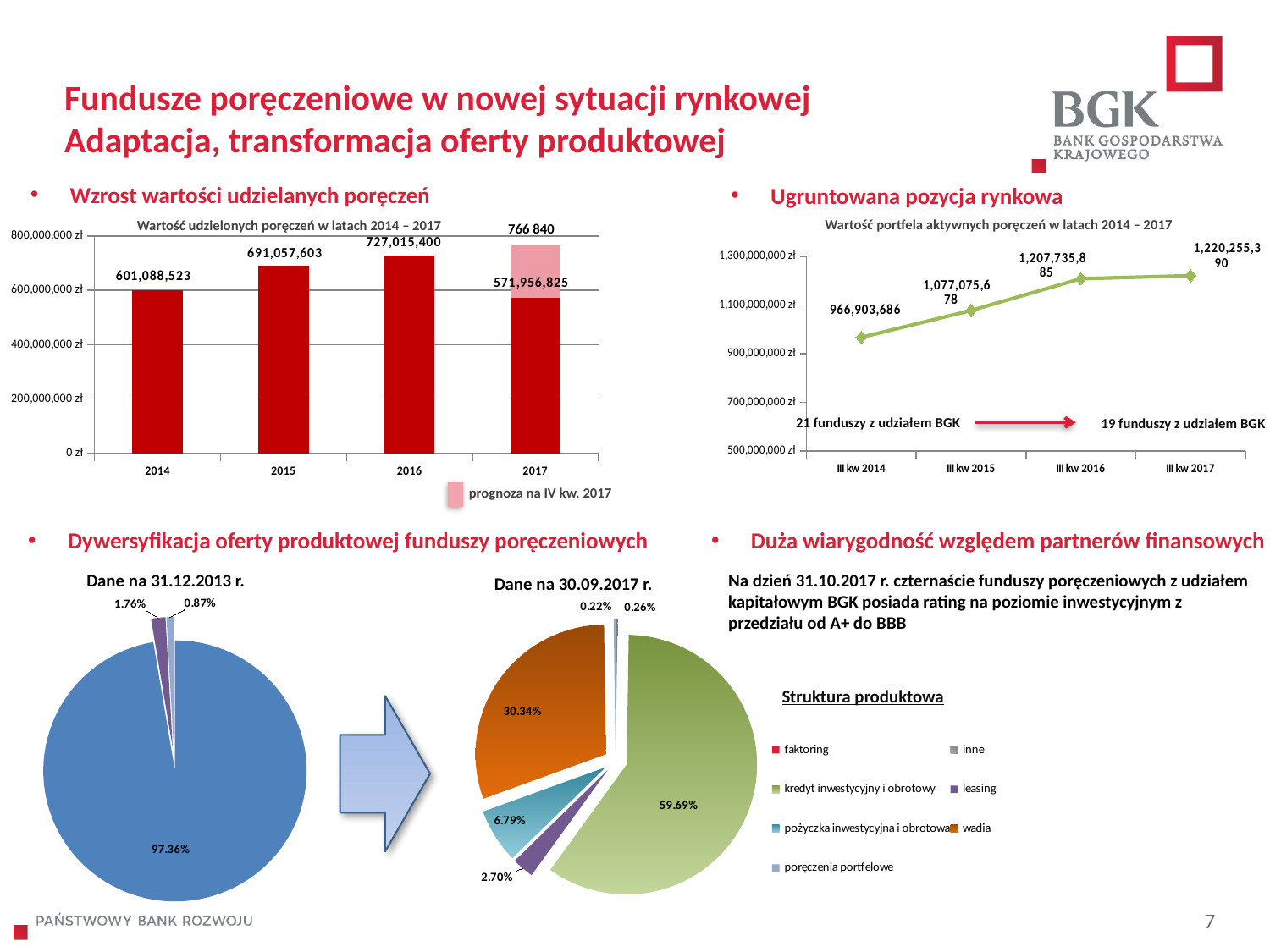
In the pie chart 'Dane na 31.12.2013 r.', what is the share of the largest slice? 97.36% What kind of chart is 'Wartość portfela aktywnych poręczeń w latach 2014 – 2017' in the top-right of the slide? line chart In the 'Wartość udzielonych poręczeń w latach 2014 – 2017' chart, what is the value for 2016? 727,015,400 In the 'Wartość portfela aktywnych poręczeń w latach 2014 – 2017' chart, do the values rise or fall from III kw 2014 to III kw 2017? rise What kind of chart is 'Wartość udzielonych poręczeń w latach 2014 – 2017' in the top-left of the slide? bar chart In the pie chart 'Dane na 30.09.2017 r.', what is the share of the largest slice? 59.69% In the 'Wartość udzielonych poręczeń w latach 2014 – 2017' chart, what is the value for 2015? 691,057,603 How many years are shown on the x axis of the 'Wartość udzielonych poręczeń w latach 2014 – 2017' chart? 4 In the 'Wartość udzielonych poręczeń w latach 2014 – 2017' chart, is the value for 2014 greater or less than 400,000,000 zł? greater In the 'Wartość udzielonych poręczeń w latach 2014 – 2017' chart, what is the difference between the 2016 and 2015 values? 35,957,797 In the 'Wartość portfela aktywnych poręczeń w latach 2014 – 2017' chart, what is the value for III kw 2014? 966,903,686 In the 'Wartość udzielonych poręczeń w latach 2014 – 2017' chart, what value is shown for the forecast (prognoza na IV kw. 2017)? 766 840